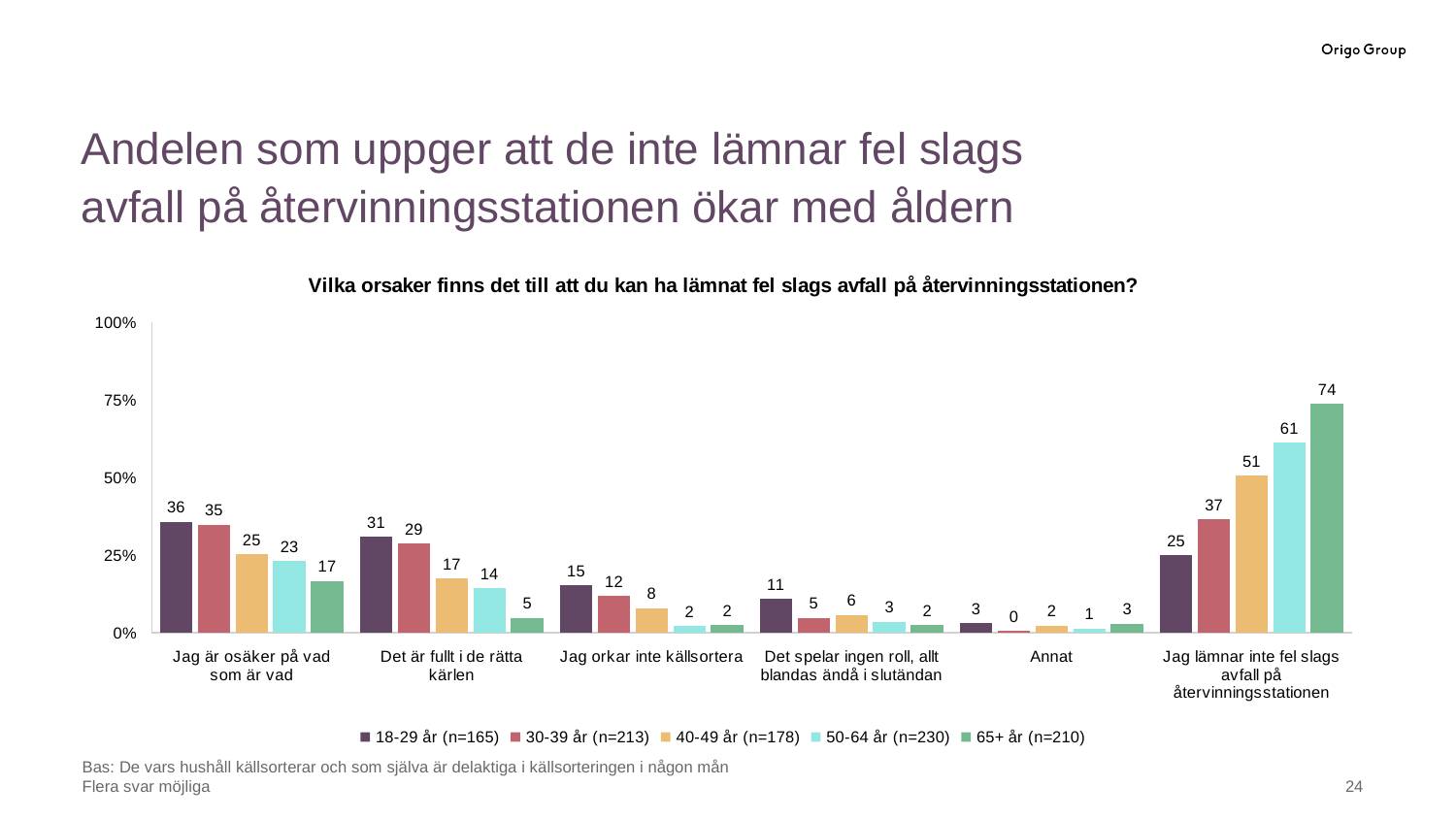
What is the difference between the 65+ år and 18-29 år values in the category "Jag lämnar inte fel slags avfall på återvinningsstationen"? 49 How many series does the legend list? 5 What is the value for the 40-49 år group in the category "Det är fullt i de rätta kärlen"? 17 What is the value for the 65+ år group in the category "Jag lämnar inte fel slags avfall på återvinningsstationen"? 74 How many categories are shown on the x axis of the chart? 6 In the category "Det är fullt i de rätta kärlen", do the values rise or fall as the age groups get older? Fall Which age group has the lowest value in the category "Annat"? 30-39 år (n=213) What kind of chart is shown on the slide? Bar chart In the category "Jag orkar inte källsortera", which is larger: the value for 18-29 år or for 40-49 år? 18-29 år What is the value for the 18-29 år group in the category "Jag är osäker på vad som är vad"? 36 Is the value for the 50-64 år group in the category "Jag lämnar inte fel slags avfall på återvinningsstationen" greater or less than 50%? greater Which age group has the highest value in the category "Jag lämnar inte fel slags avfall på återvinningsstationen"? 65+ år (n=210)